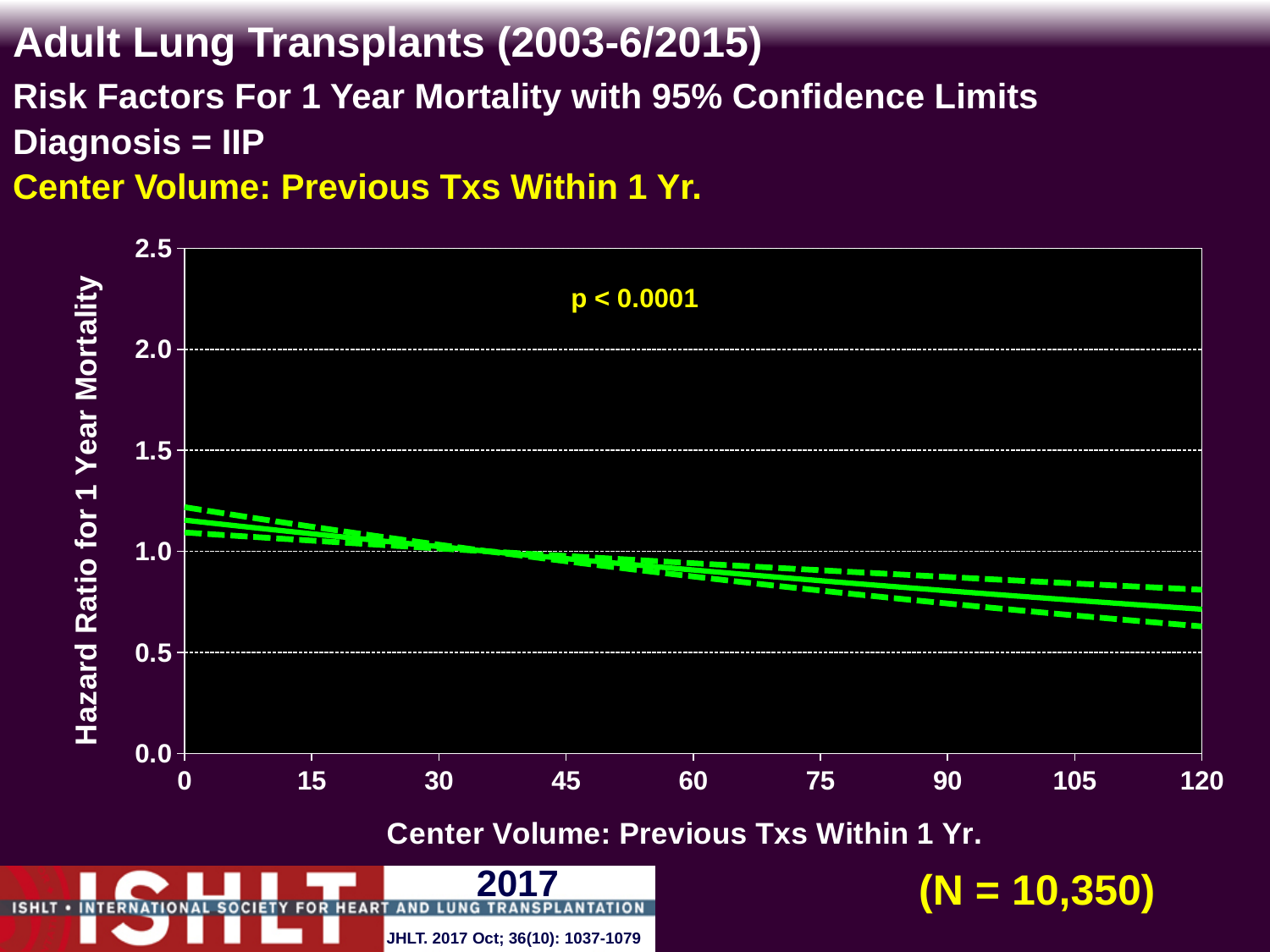
How many lines (estimate plus confidence limits) are plotted on the chart? 3 What is the maximum value shown on the x axis? 120 Is the hazard ratio at a center volume of 120 greater or less than 1.0? less Does the hazard ratio rise or fall as center volume increases along the x axis? fall What is the label of the y axis? Hazard Ratio for 1 Year Mortality Is the upper confidence limit at a center volume of 120 greater or less than 1.0? less What is the p-value printed on the chart? p < 0.0001 What is the maximum value shown on the y axis? 2.5 Is the hazard ratio at a center volume of 0 greater or less than 1.0? greater What is the sample size (N) printed on the slide? N = 10,350 What kind of chart is shown on the slide? line chart